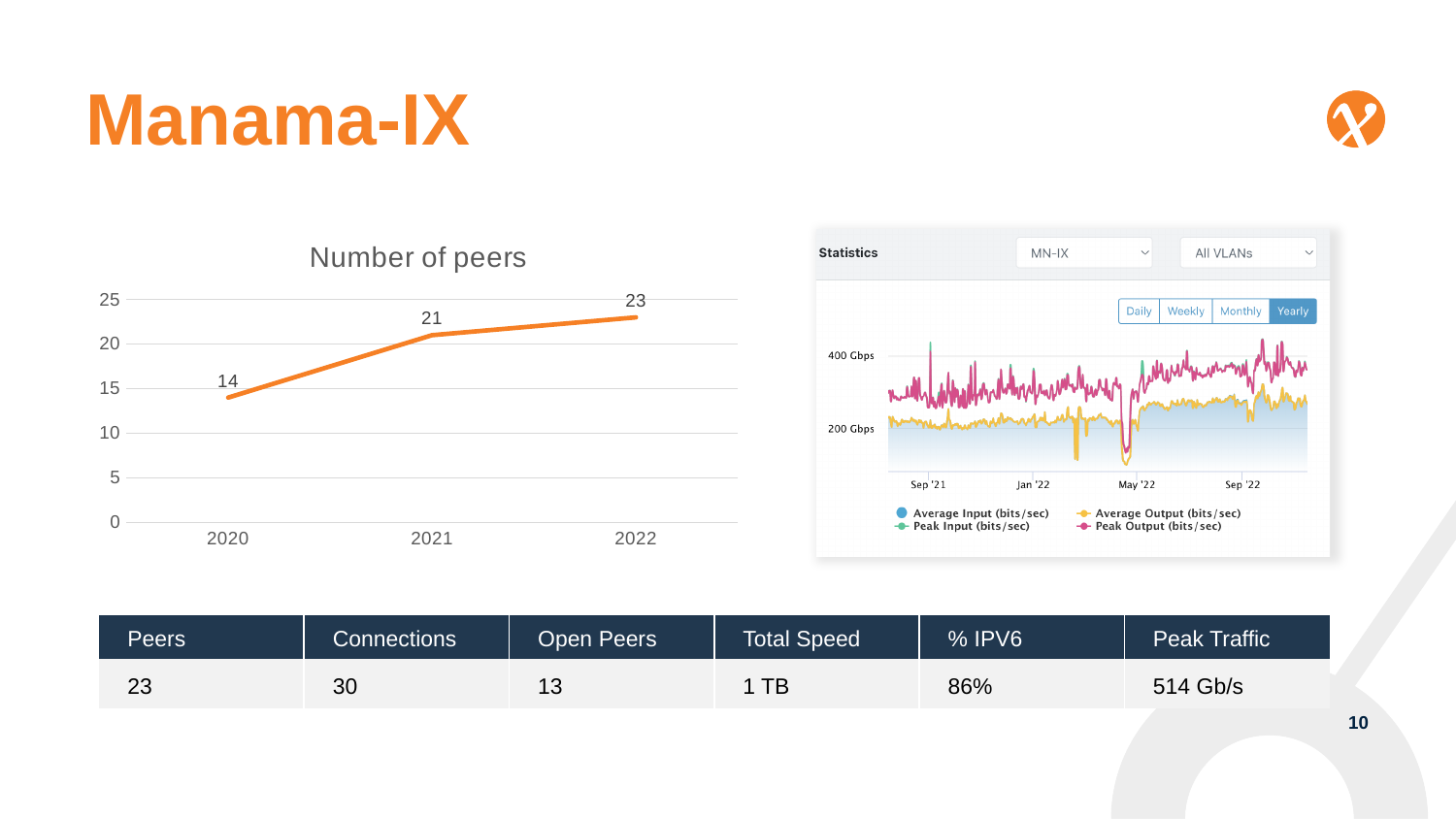
In the 'Number of peers' chart, which year has the lowest number of peers? 2020 In the 'Number of peers' chart, is the value for 2021 larger than the value for 2020? Yes What kind of chart is the 'Number of peers' chart? Line chart In the Statistics chart on the right, which time range button is selected? Yearly In the 'Number of peers' chart, what is the value for 2020? 14 In the 'Number of peers' chart, how many years are plotted? 3 In the 'Number of peers' chart, do the values rise or fall from 2020 to 2022? Rise In the 'Number of peers' chart, what is the difference between the values for 2022 and 2020? 9 In the 'Number of peers' chart, what is the value for 2021? 21 In the Statistics chart on the right, how many series does the legend list? 4 In the 'Number of peers' chart, which year has the highest number of peers? 2022 In the 'Number of peers' chart, is the value for 2022 greater or less than 20? greater